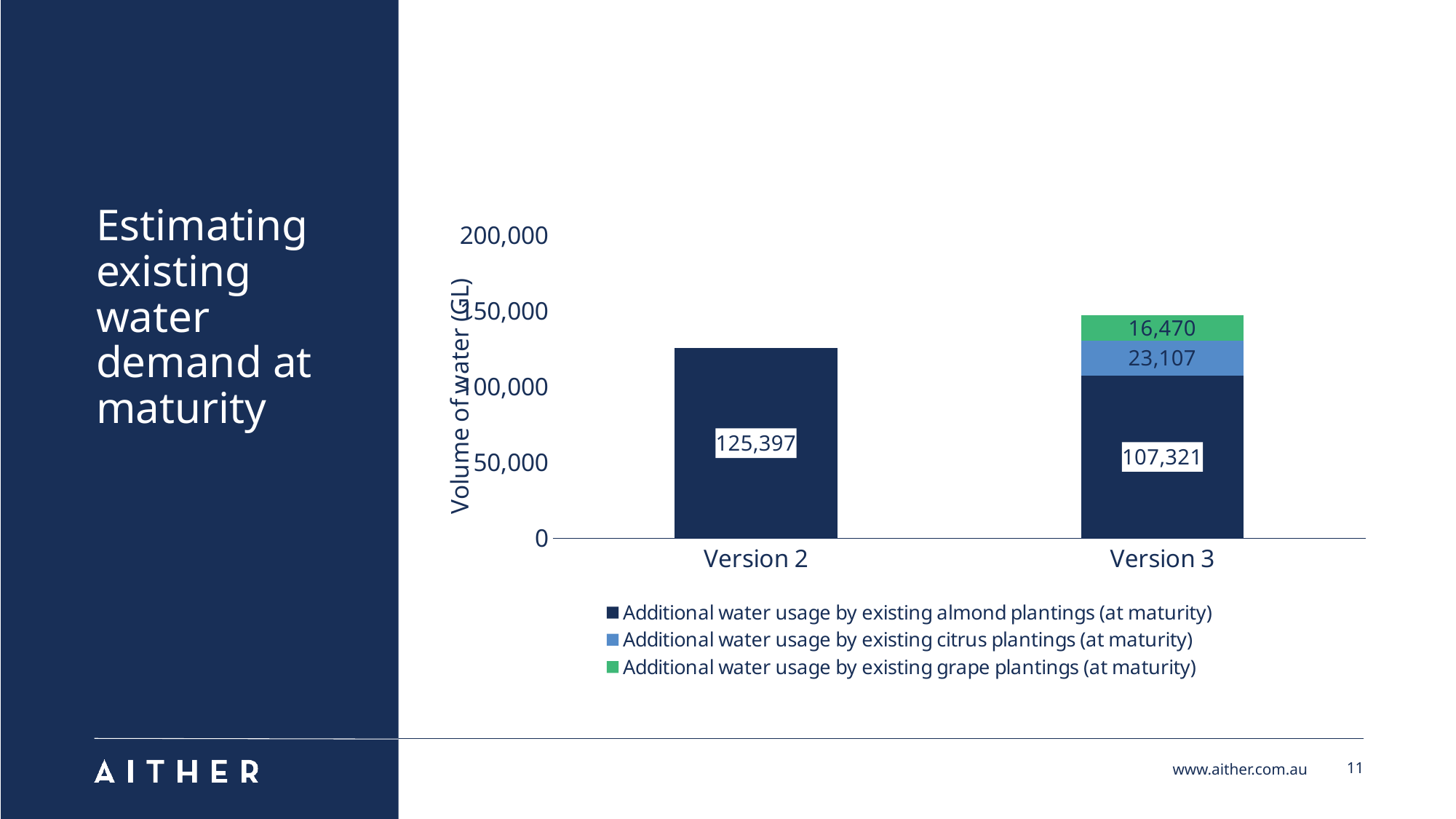
What is the label of the vertical axis? Volume of water (GL) How many categories are shown on the x axis? 2 Which version has the larger value for additional water usage by existing almond plantings, Version 2 or Version 3? Version 2 How many series does the legend list? 3 Is the total value of the Version 2 bar greater or less than 100,000? greater What is the value for additional water usage by existing citrus plantings (at maturity) for Version 3? 23,107 What is the value for additional water usage by existing grape plantings (at maturity) for Version 3? 16,470 What is the total of the stacked bar for Version 3? 146,898 What is the value for additional water usage by existing almond plantings (at maturity) for Version 2? 125,397 What is the difference between the almond plantings value for Version 2 and the almond plantings value for Version 3? 18,076 In Version 3, what is the difference between the citrus plantings value and the grape plantings value? 6,637 What is the value for additional water usage by existing almond plantings (at maturity) for Version 3? 107,321